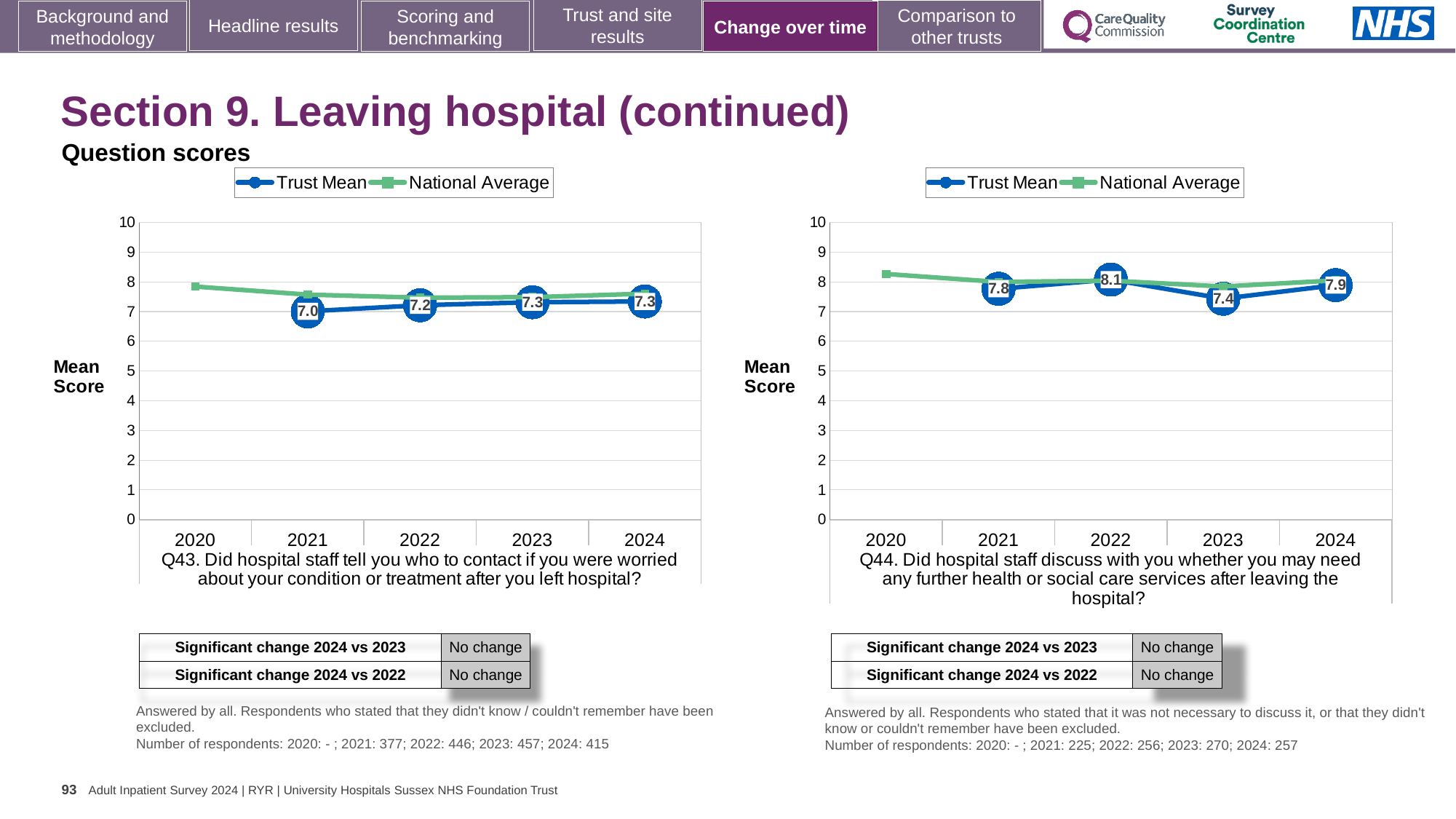
What kind of chart is the Q44 chart (right)? Line chart How many series does the legend of the Q43 chart (left) list? 2 In the Q43 chart (left), what is the Trust Mean score for 2024? 7.3 In the Q43 chart (left), what is the Trust Mean score for 2021? 7.0 In the Q43 chart (left), is the National Average value for 2020 greater or less than 7? greater In the Q44 chart (right), what is the Trust Mean score for 2022? 8.1 In the Q44 chart (right), what is the Trust Mean score for 2023? 7.4 In the Q44 chart (right), what is the difference between the Trust Mean scores for 2022 and 2023? 0.7 In the Q44 chart (right), which year has the highest Trust Mean score? 2022 In the Q43 chart (left), does the Trust Mean score rise or fall from 2021 to 2023? Rise In the Q43 chart (left), is the Trust Mean score higher in 2021 or in 2022? 2022 In the Q44 chart (right), which year has the lowest Trust Mean score? 2023